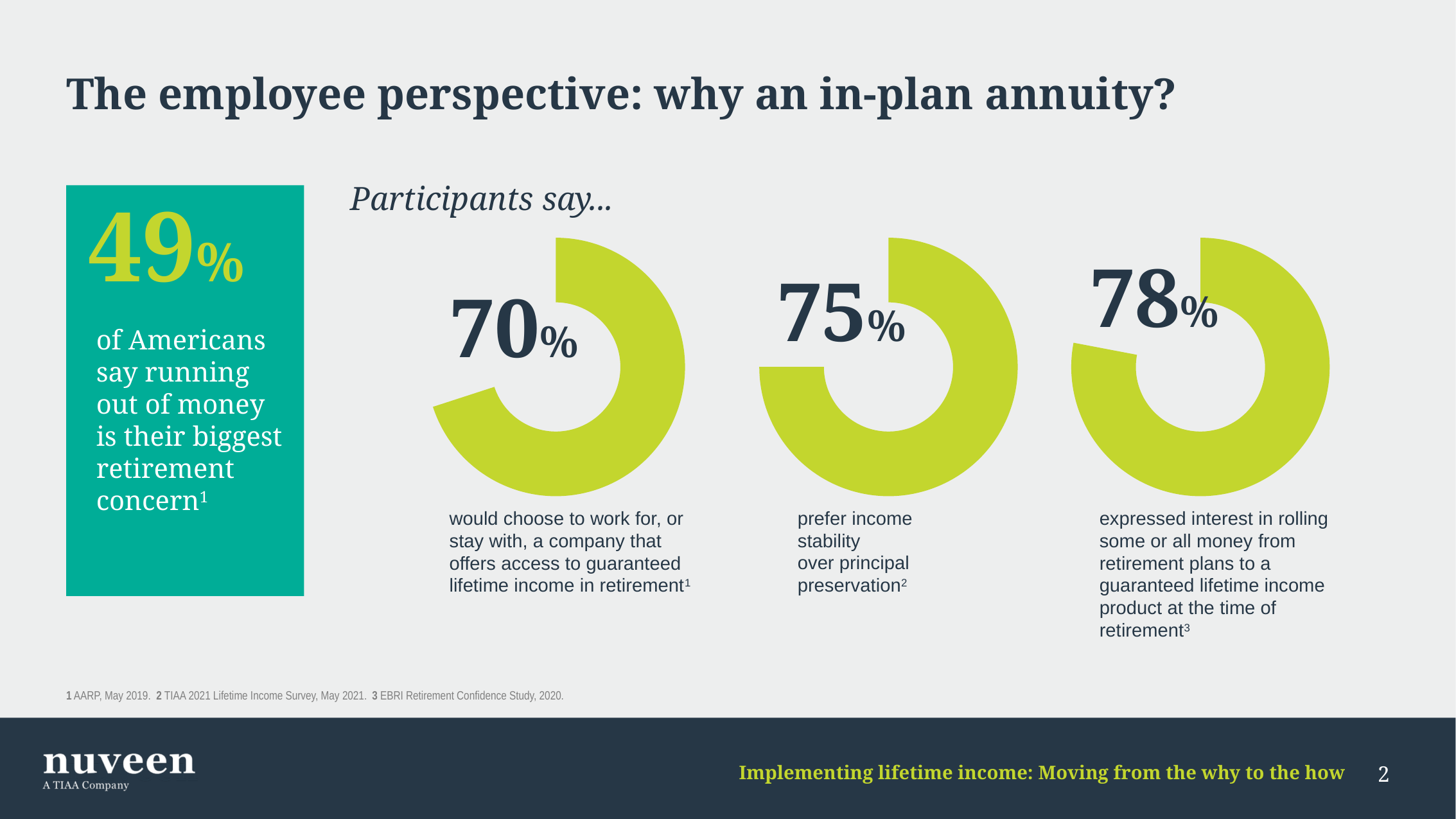
What percentage is shown in the right donut chart, for participants who expressed interest in rolling some or all money from retirement plans to a guaranteed lifetime income product at the time of retirement? 78% What percentage is shown in the left donut chart, for participants who would choose to work for, or stay with, a company that offers access to guaranteed lifetime income in retirement? 70% Of the three donut charts, which statement has the highest percentage? expressed interest in rolling some or all money from retirement plans to a guaranteed lifetime income product at the time of retirement (78%) What percentage is shown in the middle donut chart, for participants who prefer income stability over principal preservation? 75% What heading appears above the three donut charts? Participants say... What is the difference in percentage points between the middle donut chart (75%) and the left donut chart (70%)? 5 percentage points What kind of chart is used to display the 70%, 75% and 78% figures? donut chart What colour are the filled portions of the three donut charts? lime green Which is larger: the percentage in the middle donut chart (prefer income stability) or the percentage in the right donut chart (interest in rolling money to a guaranteed lifetime income product)? the right donut chart (78%) How many donut charts are shown under the heading 'Participants say...'? 3 What is the difference in percentage points between the right donut chart (78%) and the left donut chart (70%)? 8 percentage points Of the three donut charts, which statement has the lowest percentage? would choose to work for, or stay with, a company that offers access to guaranteed lifetime income in retirement (70%)